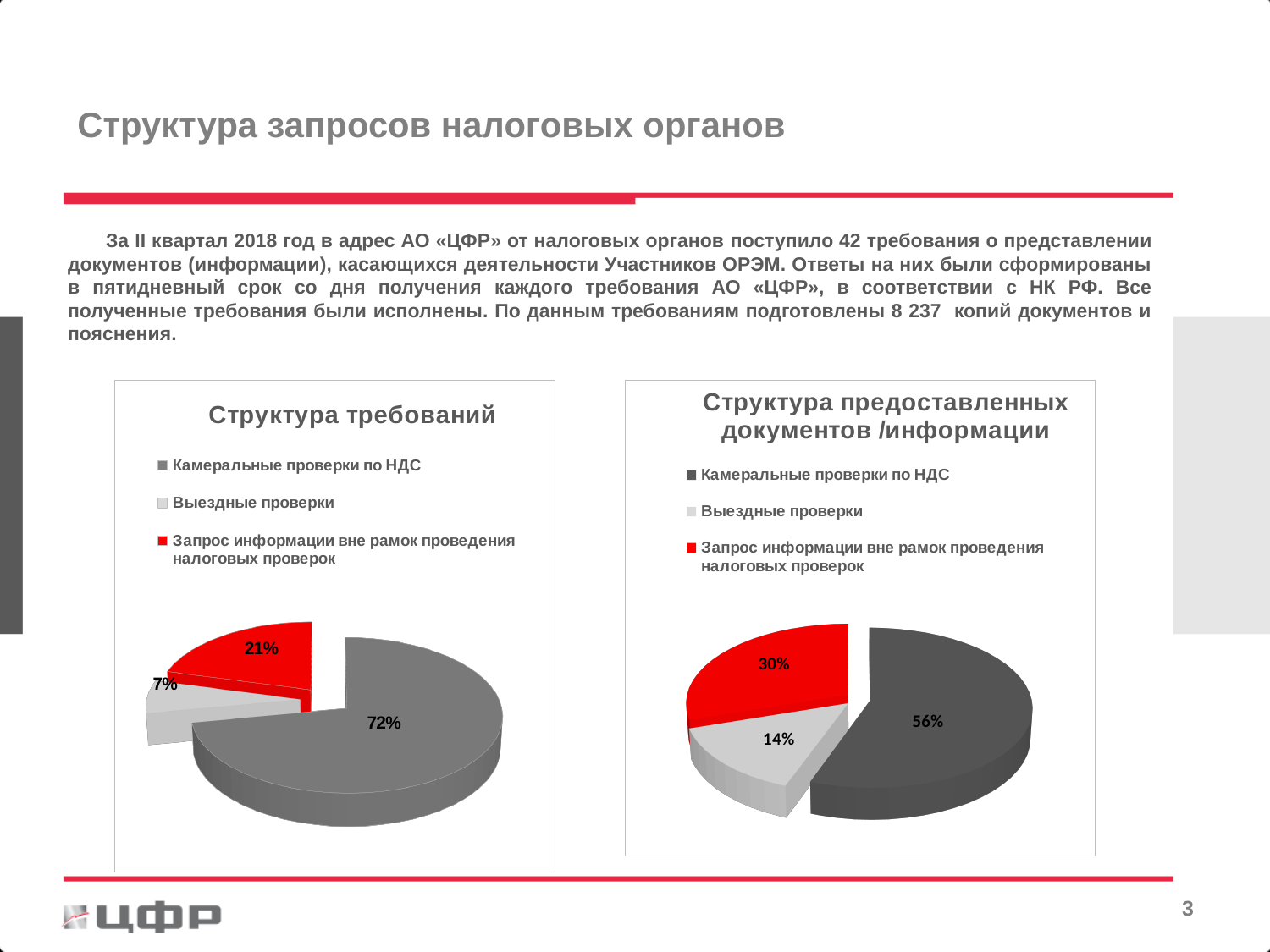
In the chart titled "Структура предоставленных документов /информации", what is the difference in percentage points between "Камеральные проверки по НДС" and "Запрос информации вне рамок проведения налоговых проверок"? 26 In the chart titled "Структура предоставленных документов /информации", what share does "Камеральные проверки по НДС" have? 56% What type of chart is the chart titled "Структура предоставленных документов /информации"? Pie chart In the chart titled "Структура предоставленных документов /информации", what share does "Выездные проверки" have? 14% In the chart titled "Структура требований", what share does "Выездные проверки" have? 7% In the chart titled "Структура требований", what share does "Запрос информации вне рамок проведения налоговых проверок" have? 21% In the chart titled "Структура требований", which category has the largest slice? Камеральные проверки по НДС In the chart titled "Структура предоставленных документов /информации", what share does "Запрос информации вне рамок проведения налоговых проверок" have? 30% In the chart titled "Структура предоставленных документов /информации", which category has the smallest slice? Выездные проверки How many categories does the legend of the chart titled "Структура требований" list? 3 In the chart titled "Структура требований", what share does "Камеральные проверки по НДС" have? 72% In the chart titled "Структура требований", which is larger: "Выездные проверки" or "Запрос информации вне рамок проведения налоговых проверок"? Запрос информации вне рамок проведения налоговых проверок